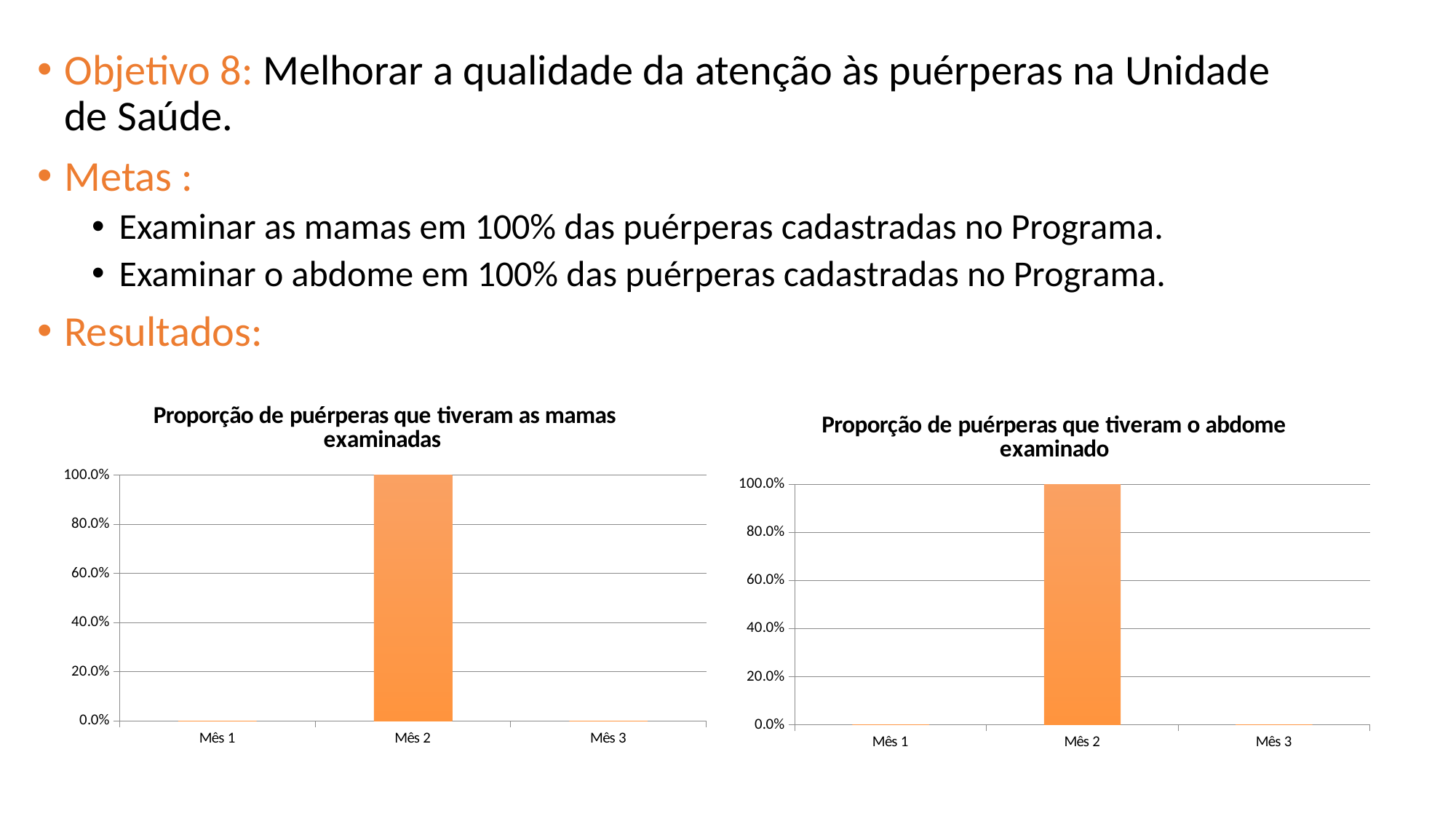
In the chart 'Proporção de puérperas que tiveram o abdome examinado', which month has the highest value? Mês 2 In the chart 'Proporção de puérperas que tiveram as mamas examinadas', which is larger, the value for Mês 2 or the value for Mês 3? Mês 2 How many months are shown on the x axis of the chart 'Proporção de puérperas que tiveram as mamas examinadas'? 3 In the chart 'Proporção de puérperas que tiveram as mamas examinadas', is the value for Mês 1 greater or less than 20.0%? less What kind of chart is 'Proporção de puérperas que tiveram o abdome examinado'? bar chart In the chart 'Proporção de puérperas que tiveram as mamas examinadas', which month has the highest value? Mês 2 In the chart 'Proporção de puérperas que tiveram o abdome examinado', which is larger, the value for Mês 1 or the value for Mês 2? Mês 2 In the chart 'Proporção de puérperas que tiveram o abdome examinado', what is the value for Mês 2? 100.0% How many charts are shown on the slide? 2 What is the title of the chart on the right side of the slide? Proporção de puérperas que tiveram o abdome examinado In the chart 'Proporção de puérperas que tiveram o abdome examinado', is the value for Mês 3 greater or less than 20.0%? less In the chart 'Proporção de puérperas que tiveram as mamas examinadas', what is the value for Mês 2? 100.0%